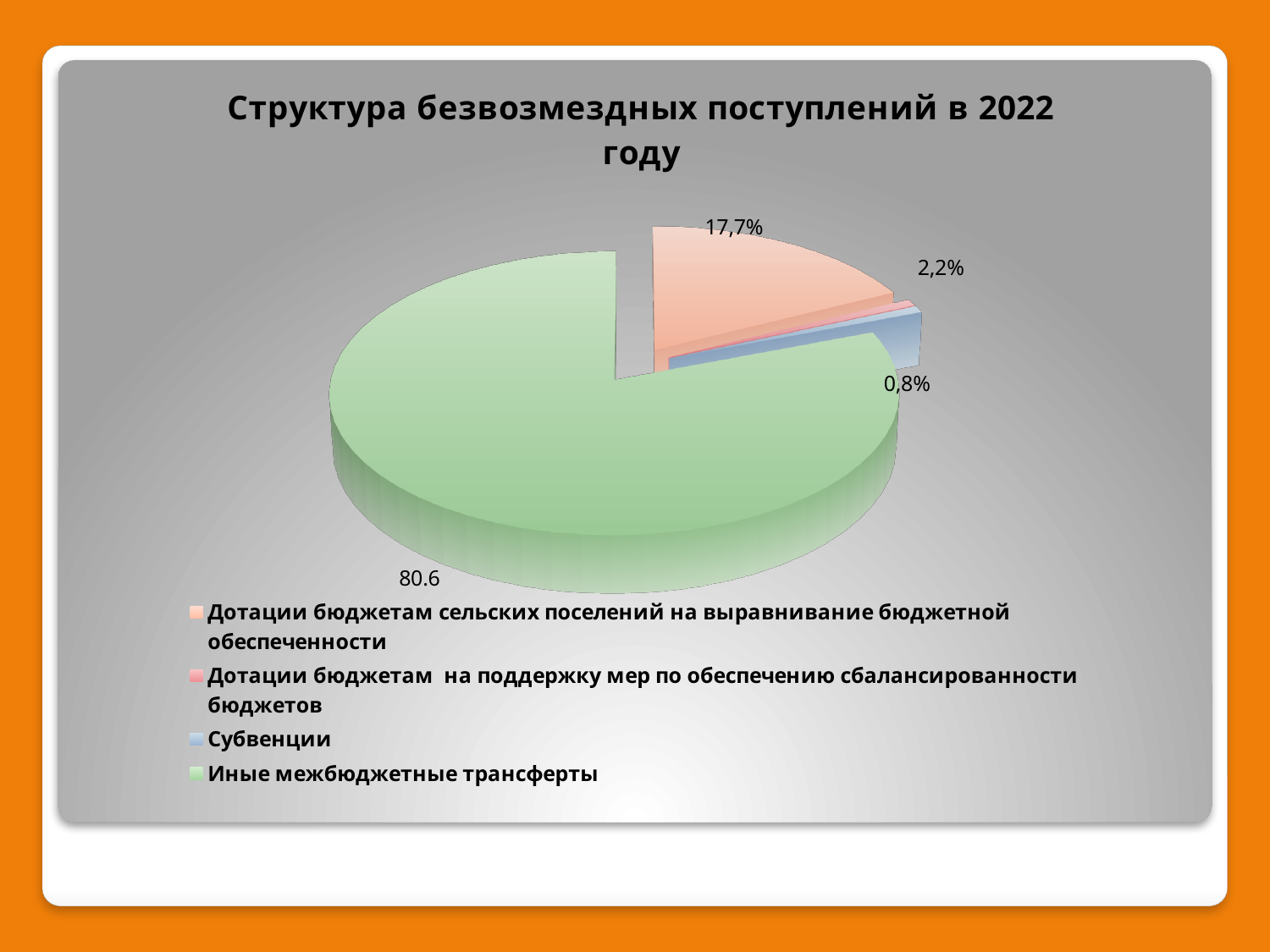
What colour is the slice for Иные межбюджетные трансферты? green How many slices does the pie chart have? 4 Which is larger: the slice for Иные межбюджетные трансферты or the slice for Дотации бюджетам сельских поселений на выравнивание бюджетной обеспеченности? Иные межбюджетные трансферты What share of the pie is labelled for Дотации бюджетам сельских поселений на выравнивание бюджетной обеспеченности? 17,7% Which category has the largest slice of the pie? Иные межбюджетные трансферты What kind of chart is shown on the slide? pie chart Is the share for Иные межбюджетные трансферты greater or less than 50%? greater How many categories does the legend list? 4 What is the smallest percentage value labelled on the pie chart? 0,8% What is the title of the chart? Структура безвозмездных поступлений в 2022 году What share of the pie is labelled for Иные межбюджетные трансферты? 80.6 Which is larger: the slice for Субвенции or the slice for Дотации бюджетам сельских поселений на выравнивание бюджетной обеспеченности? Дотации бюджетам сельских поселений на выравнивание бюджетной обеспеченности